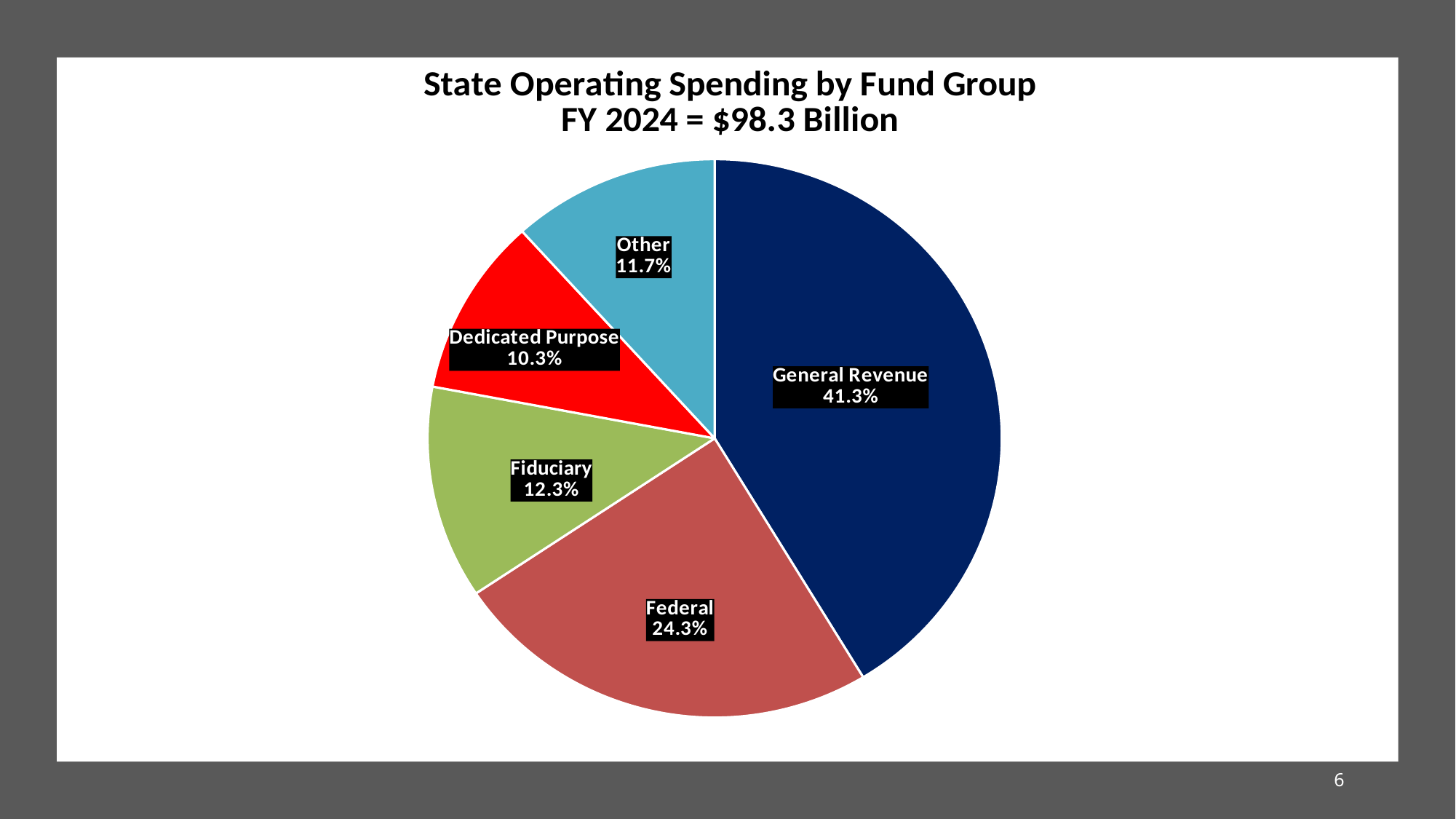
What share of state operating spending is Other? 11.7% What share of state operating spending is Fiduciary? 12.3% What is the difference in percentage points between General Revenue and Federal? 17.0% How many fund groups are shown in the pie chart? 5 Which fund group has the largest share of spending? General Revenue What share of state operating spending is Dedicated Purpose? 10.3% What total spending amount for FY 2024 is given in the chart title? $98.3 Billion Which fund group has the smallest share of spending? Dedicated Purpose What type of chart is shown on the slide? pie chart Which is larger, the Fiduciary share or the Other share? Fiduciary